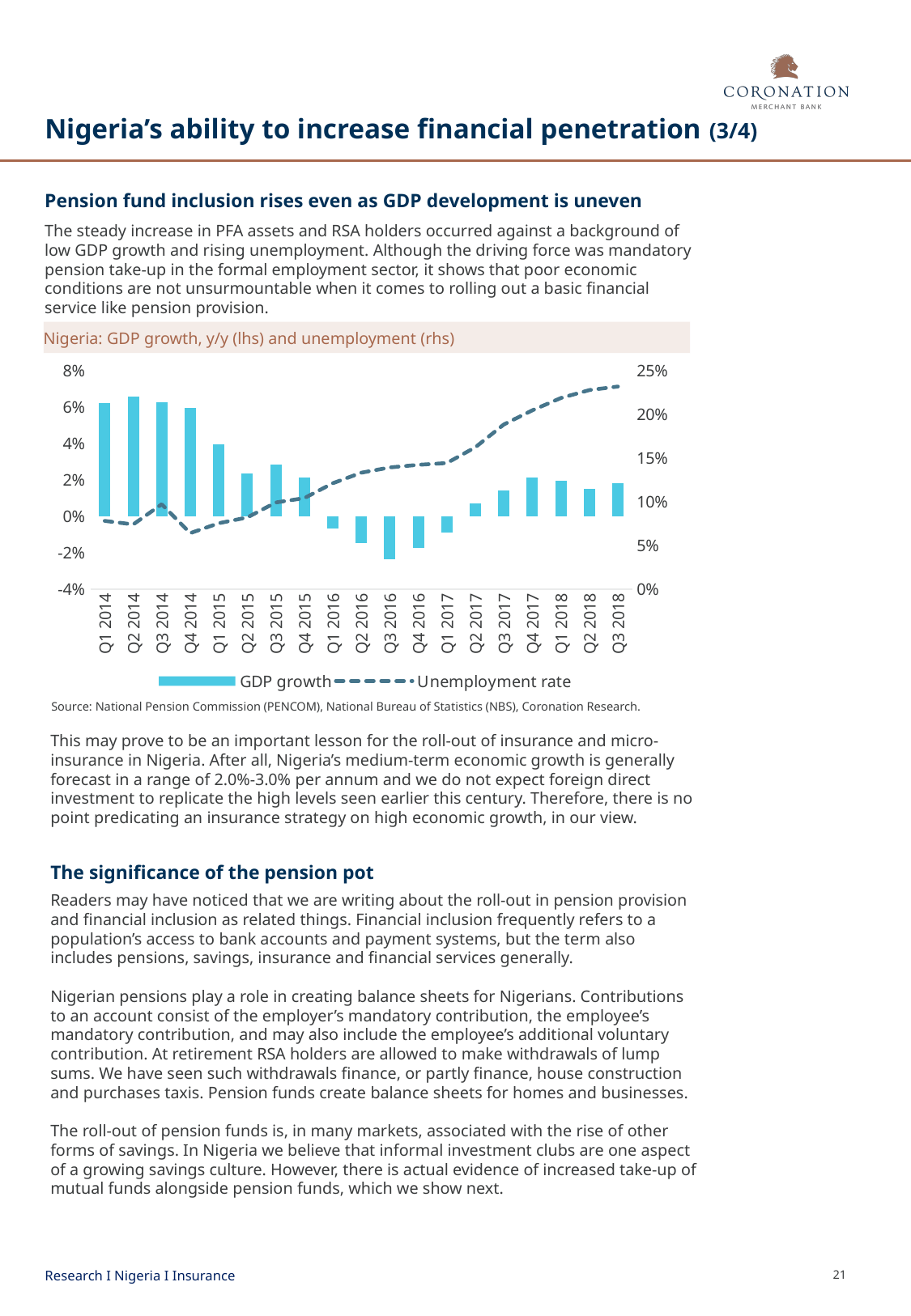
Which quarter has the lowest GDP growth bar? Q3 2016 Which quarter has the highest GDP growth bar? Q2 2014 How many quarters are plotted along the x axis of the chart? 19 What kind of chart is used to show GDP growth? Bar chart Is the GDP growth value for Q1 2015 greater or less than 2%? greater Is the unemployment rate for Q3 2018 greater or less than 20%? greater What is the title of the chart? Nigeria: GDP growth, y/y (lhs) and unemployment (rhs) Is the unemployment rate for Q1 2014 greater or less than 10%? less How many series does the chart's legend list? 2 Does the unemployment rate generally rise or fall from Q1 2014 to Q3 2018? Rise Which quarter has higher GDP growth, Q1 2015 or Q2 2015? Q1 2015